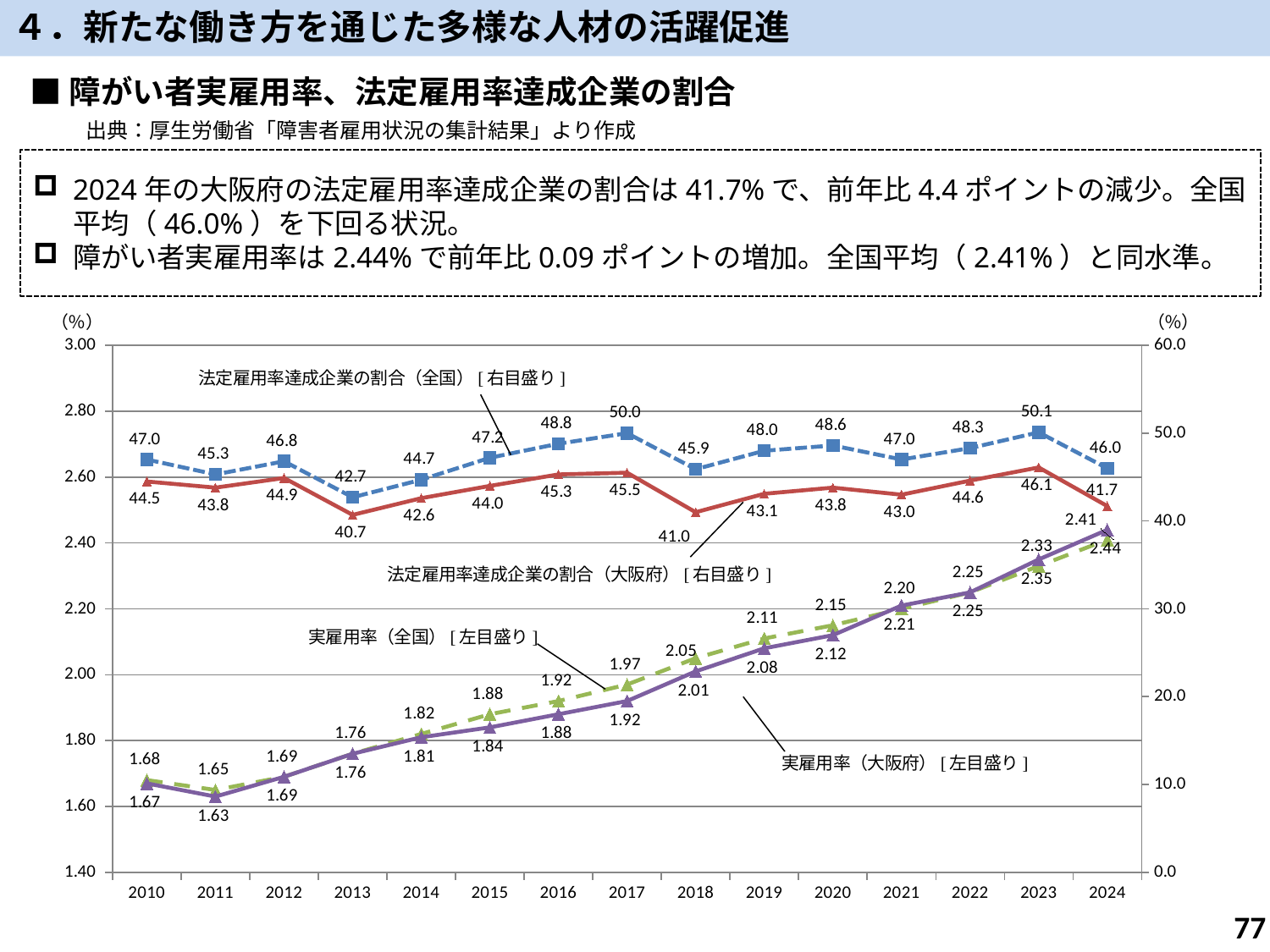
法定雇用率達成企業の割合（大阪府）が最も低かった年はいつですか？ 2013 2017年の法定雇用率達成企業の割合（全国）の値はいくつですか？ 50.0 グラフには何年分のデータ点がありますか？ 15 実雇用率（大阪府）は2010年から2024年にかけて全体として上昇していますか、下降していますか？ 上昇 2015年の実雇用率（全国）の値はいくつですか？ 1.88 2024年の法定雇用率達成企業の割合（大阪府）の値はいくつですか？ 41.7 法定雇用率達成企業の割合（全国）が最も高かった年はいつですか？ 2023 2024年の実雇用率（大阪府）の値はいくつですか？ 2.44 このグラフはどの種類のグラフですか？ 折れ線グラフ 2024年の法定雇用率達成企業の割合について、全国と大阪府の差は何ポイントですか？ 4.3 2023年の実雇用率は、全国と大阪府のどちらが高いですか？ 大阪府 グラフには何本の系列（線）が描かれていますか？ 4